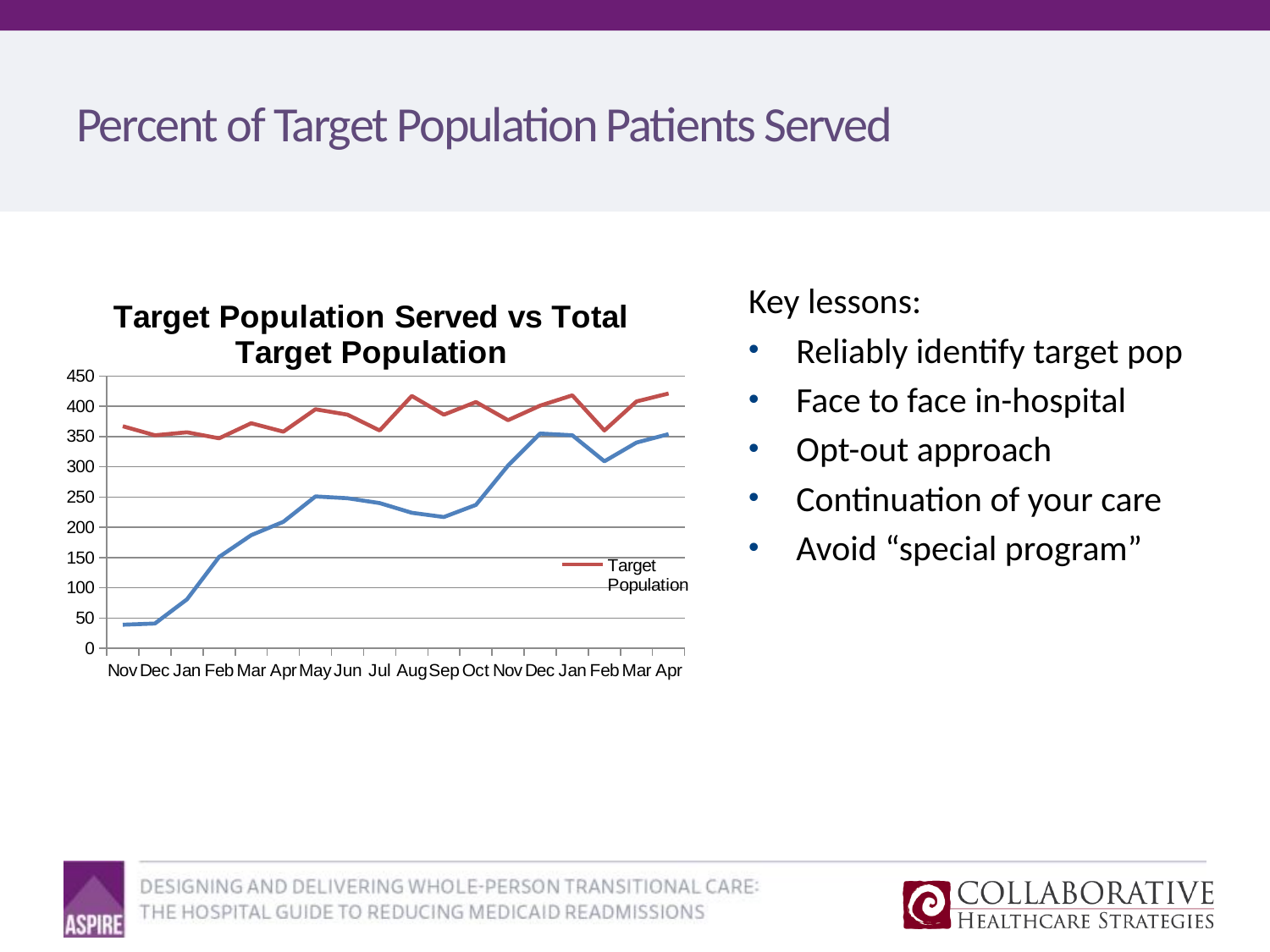
Which month has the higher Target Population value, Aug or Sep? Aug Does the Target Population line overall rise or fall from the first Nov to the final Apr? rise What type of chart is shown on the slide? line chart What is the title of the chart? Target Population Served vs Total Target Population Is the value of the blue line for the first Nov greater or less than 50? less Is the Target Population value for the first Nov greater or less than 350? greater Is the Target Population value for Aug greater or less than 400? greater How many series does the chart's legend list? 1 How many months are plotted along the x axis of the chart? 18 Which line is higher in the first Nov, the red Target Population line or the blue line? Target Population